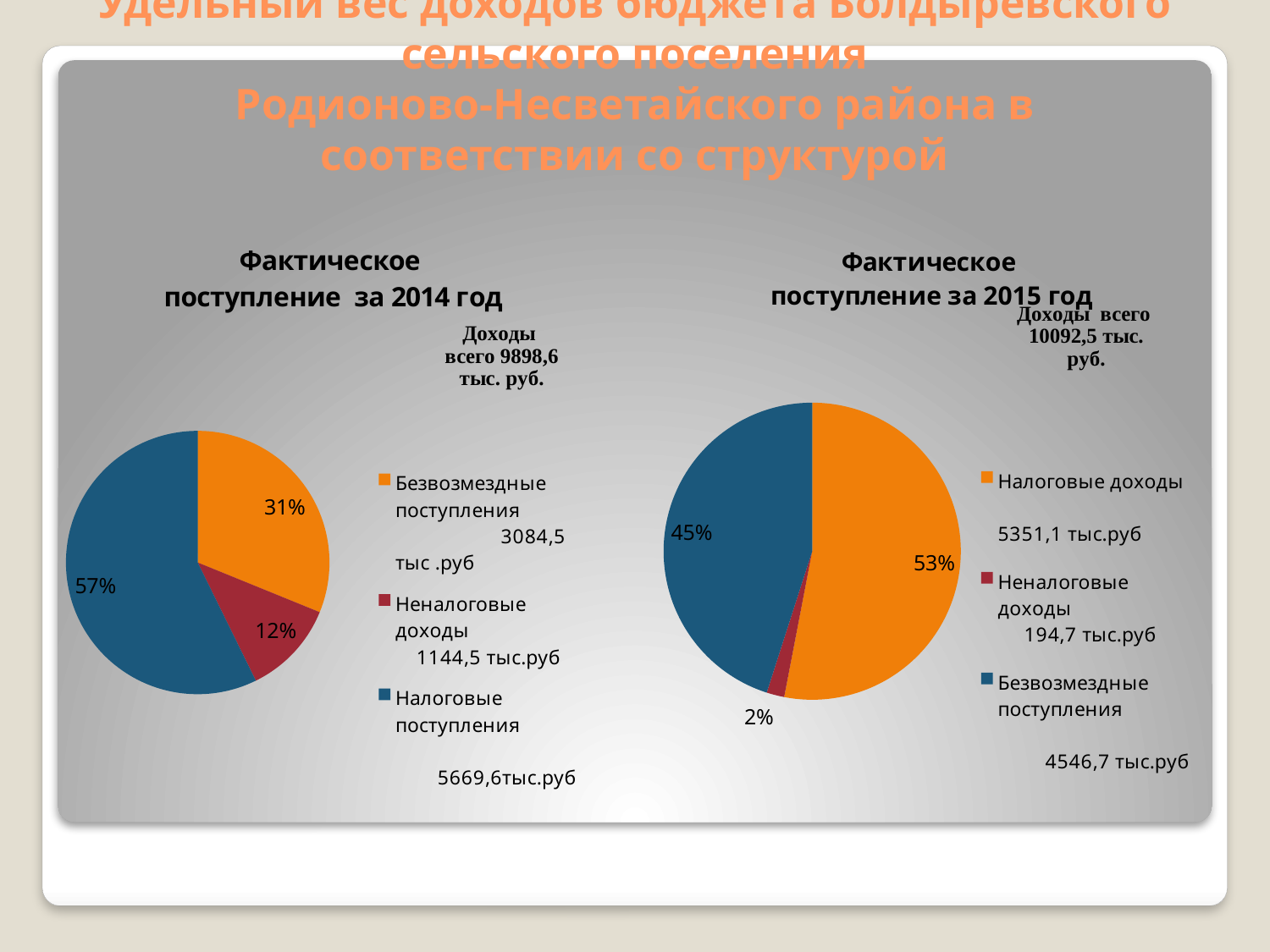
In the chart "Фактическое поступление за 2014 год", what share of the pie is "Безвозмездные поступления"? 31% In the chart "Фактическое поступление за 2014 год", which category has the smallest slice? Неналоговые доходы In the chart "Фактическое поступление за 2014 год", what is the difference in percentage points between "Налоговые поступления" and "Безвозмездные поступления"? 26 In the chart "Фактическое поступление за 2015 год", which is larger: "Налоговые доходы" or "Безвозмездные поступления"? Налоговые доходы In the chart "Фактическое поступление за 2014 год", what share of the pie is "Налоговые поступления"? 57% In the chart "Фактическое поступление за 2015 год", how many entries does the legend list? 3 In the chart "Фактическое поступление за 2014 год", how many slices does the pie have? 3 In the chart "Фактическое поступление за 2015 год", what share of the pie is "Неналоговые доходы"? 2% What kind of chart is used for "Фактическое поступление за 2014 год"? Pie chart In the chart "Фактическое поступление за 2015 год", which category has the largest slice? Налоговые доходы In the chart "Фактическое поступление за 2015 год", what is the difference in percentage points between "Налоговые доходы" and "Безвозмездные поступления"? 8